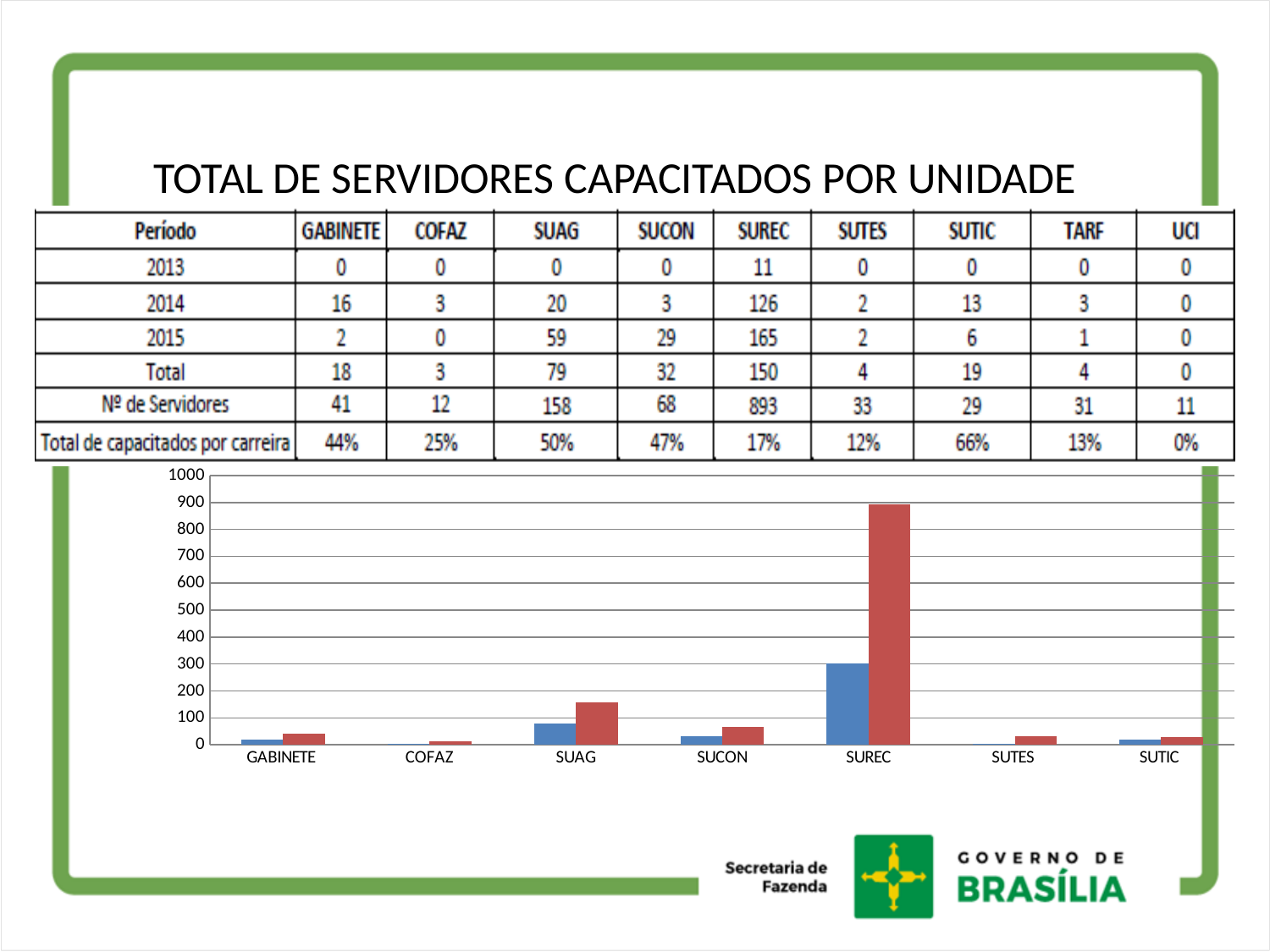
What kind of chart is shown below the table on the slide? bar chart Which category has the tallest bar in the bar chart? SUREC In the bar chart, is the red bar for SUREC greater or less than 800? greater In the bar chart, is the red bar for SUAG greater or less than 100? greater What is the highest value shown on the y axis of the bar chart? 1000 What is the first category label on the x axis of the bar chart? GABINETE In the bar chart, is the blue bar for SUREC greater or less than 200? greater Which category has the smallest bars in the bar chart? COFAZ In the bar chart, which category has the larger red bar, SUAG or SUCON? SUAG How many series of bars are plotted for each category in the bar chart? 2 How many categories are shown on the x axis of the bar chart? 7